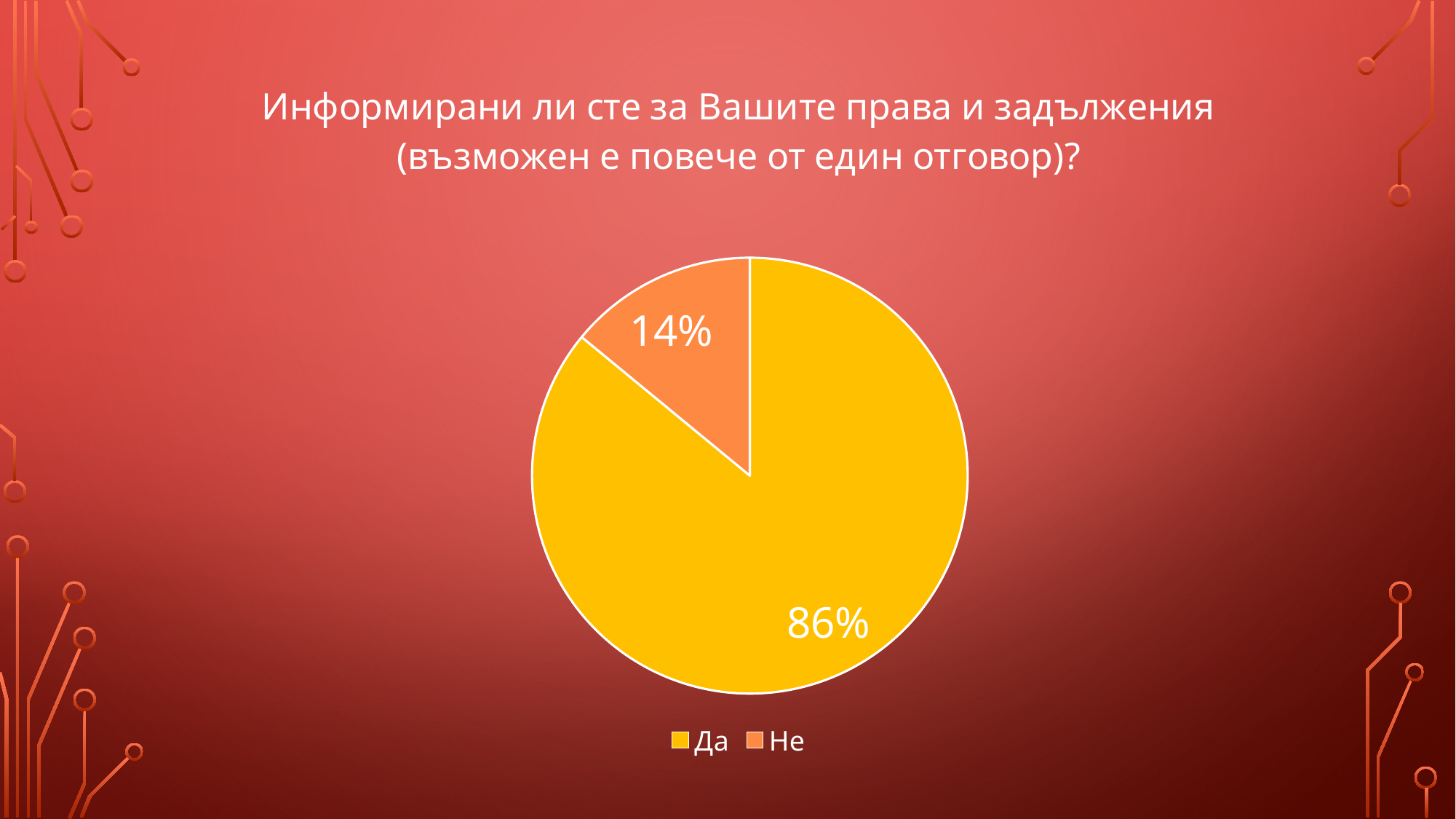
What is the title of the chart? Информирани ли сте за Вашите права и задължения (възможен е повече от един отговор)? How many entries does the legend list? 2 What is the difference in percentage points between the "Да" and "Не" slices? 72 What share of the pie does "Не" represent? 14% How many slices does the pie chart have? 2 What colour is the "Да" slice? Yellow What share of the pie does "Да" represent? 86% Which category has the largest slice of the pie? Да Which category has the smallest slice of the pie? Не What kind of chart is shown on the slide? Pie chart Which slice is larger, "Да" or "Не"? Да